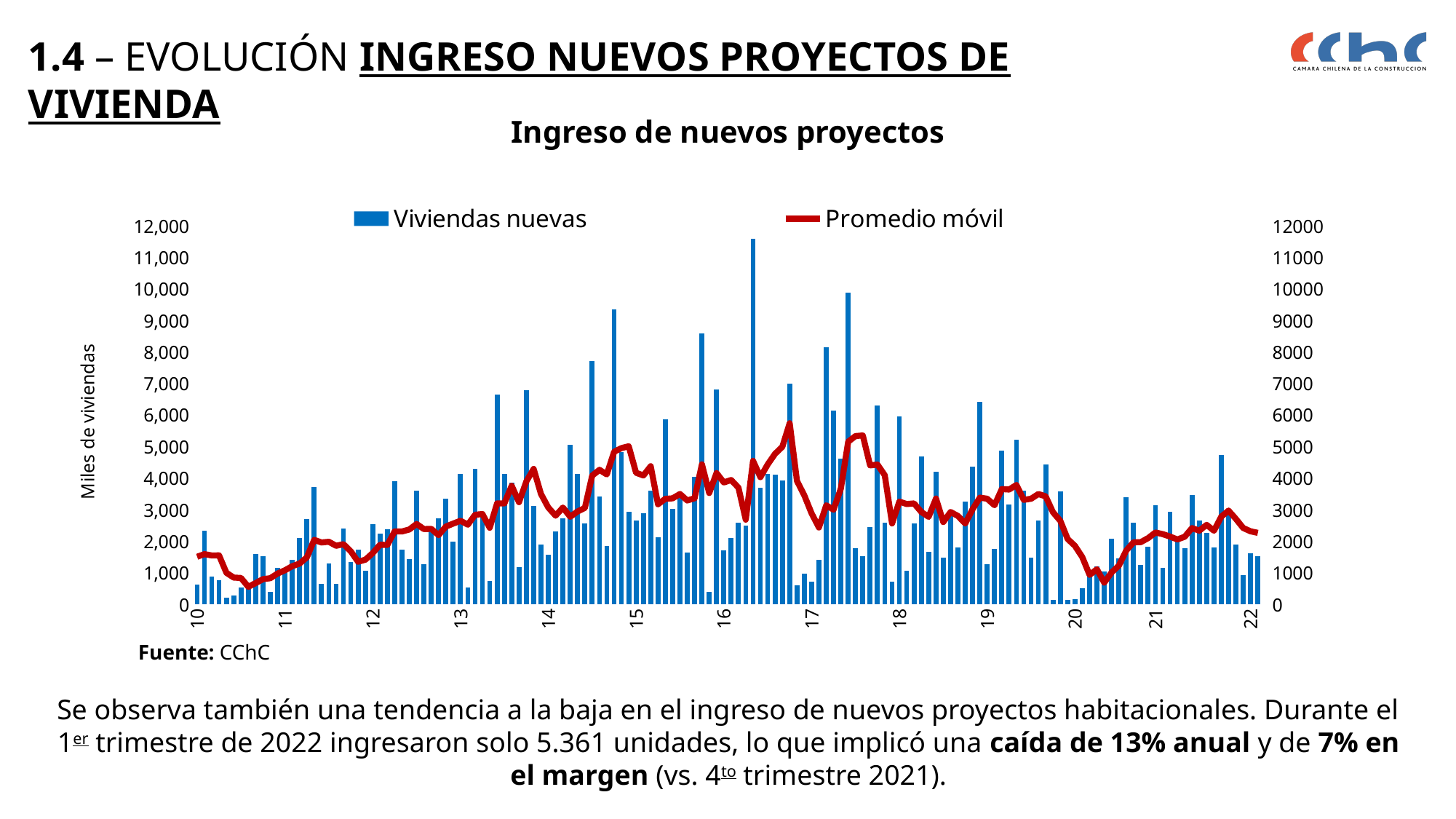
Is the tallest bar in the chart greater or less than 11,000? greater Does the Promedio móvil line generally rise or fall between 2017 and 2020? fall What are the two series named in the chart legend? Viviendas nuevas and Promedio móvil How many series does the chart legend list? 2 In which year does the tallest bar of Viviendas nuevas occur? 16 Is the tallest bar near the 17 label on the x axis greater or less than 9,000? greater Does the Promedio móvil line generally rise or fall between 2010 and 2016? rise Is the peak of the Promedio móvil line, reached around 2016-2017, greater or less than 5,000? greater What kind of chart is shown on the slide? A combined bar and line chart What is the title of the chart? Ingreso de nuevos proyectos